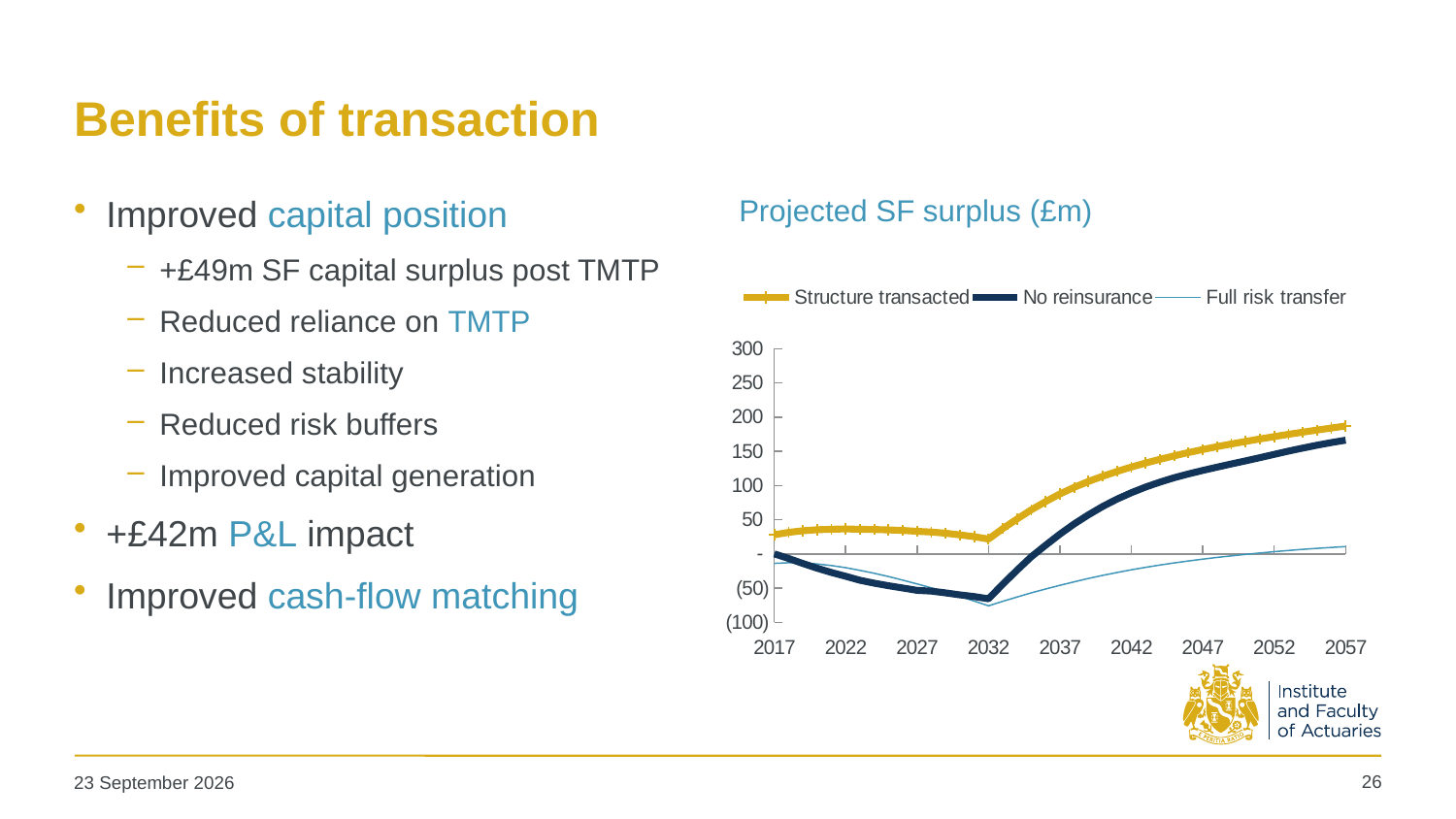
Does the No reinsurance line rise or fall between 2017 and 2032? Falls In 2057, which is higher: Structure transacted or No reinsurance? Structure transacted Is the value for No reinsurance in 2032 greater or less than 0? less Is the value for Structure transacted in 2017 greater or less than 100? less What kind of chart is shown under the title 'Projected SF surplus (£m)'? Line chart Which series has the lowest value in 2057? Full risk transfer Which series in the legend is drawn in gold/yellow? Structure transacted How many series does the legend of the 'Projected SF surplus (£m)' chart list? 3 Is the value for Full risk transfer in 2057 greater or less than 50? less Does the Structure transacted line rise or fall between 2032 and 2057? Rises What is the title of the chart on the slide? Projected SF surplus (£m)